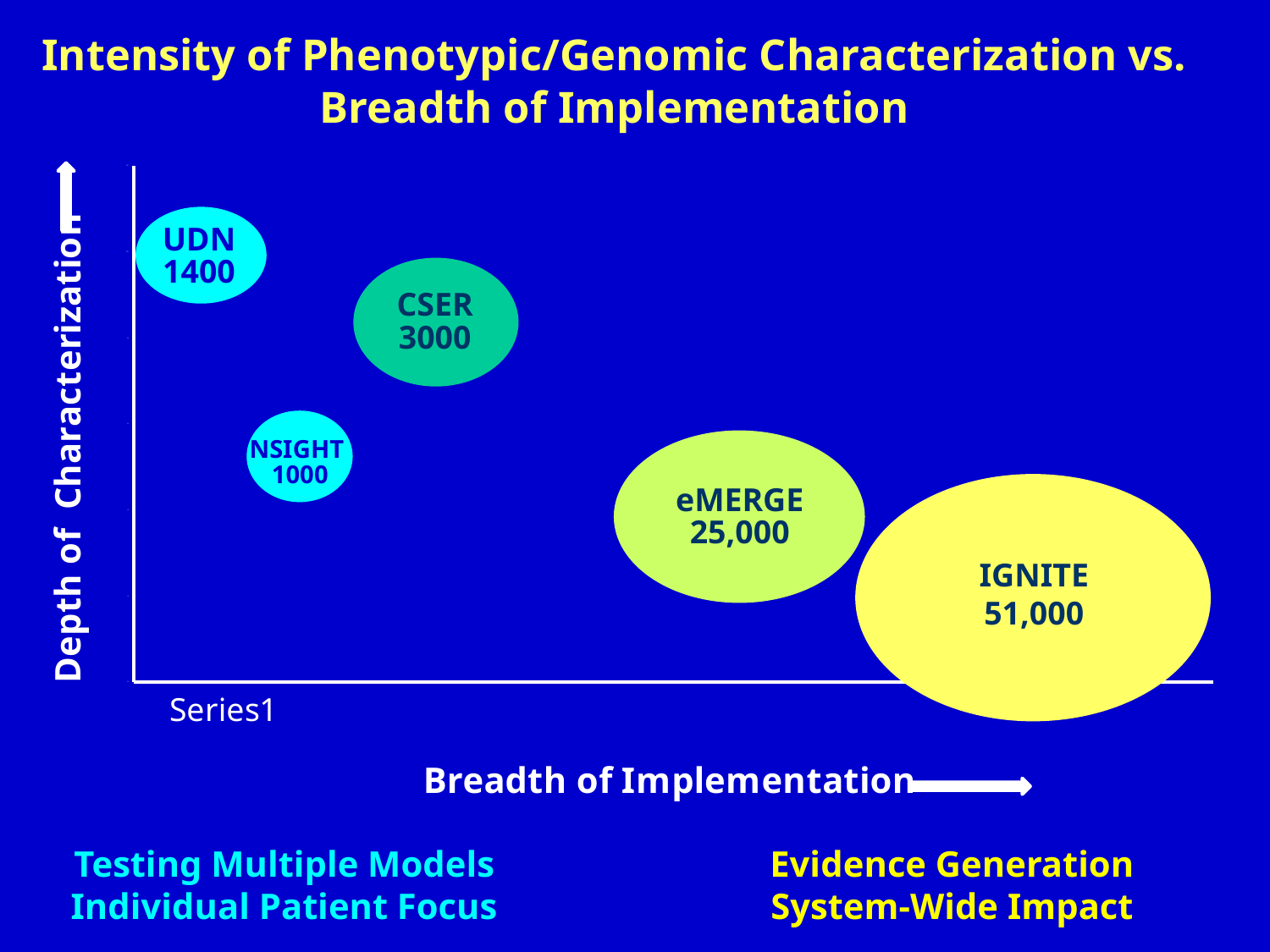
What number is shown for IGNITE? 51,000 What number is shown for eMERGE? 25,000 Which has a larger number shown, UDN or NSIGHT? UDN What is the difference between the numbers shown for CSER and UDN? 1600 What is the difference between the numbers shown for IGNITE and eMERGE? 26,000 What number is shown for UDN? 1400 Which program has the smallest number shown? NSIGHT How many programs (bubbles) are plotted on the chart? 5 Which program has the largest number shown? IGNITE What is the label of the horizontal axis? Breadth of Implementation What number is shown for CSER? 3000 What kind of chart is this? Bubble chart